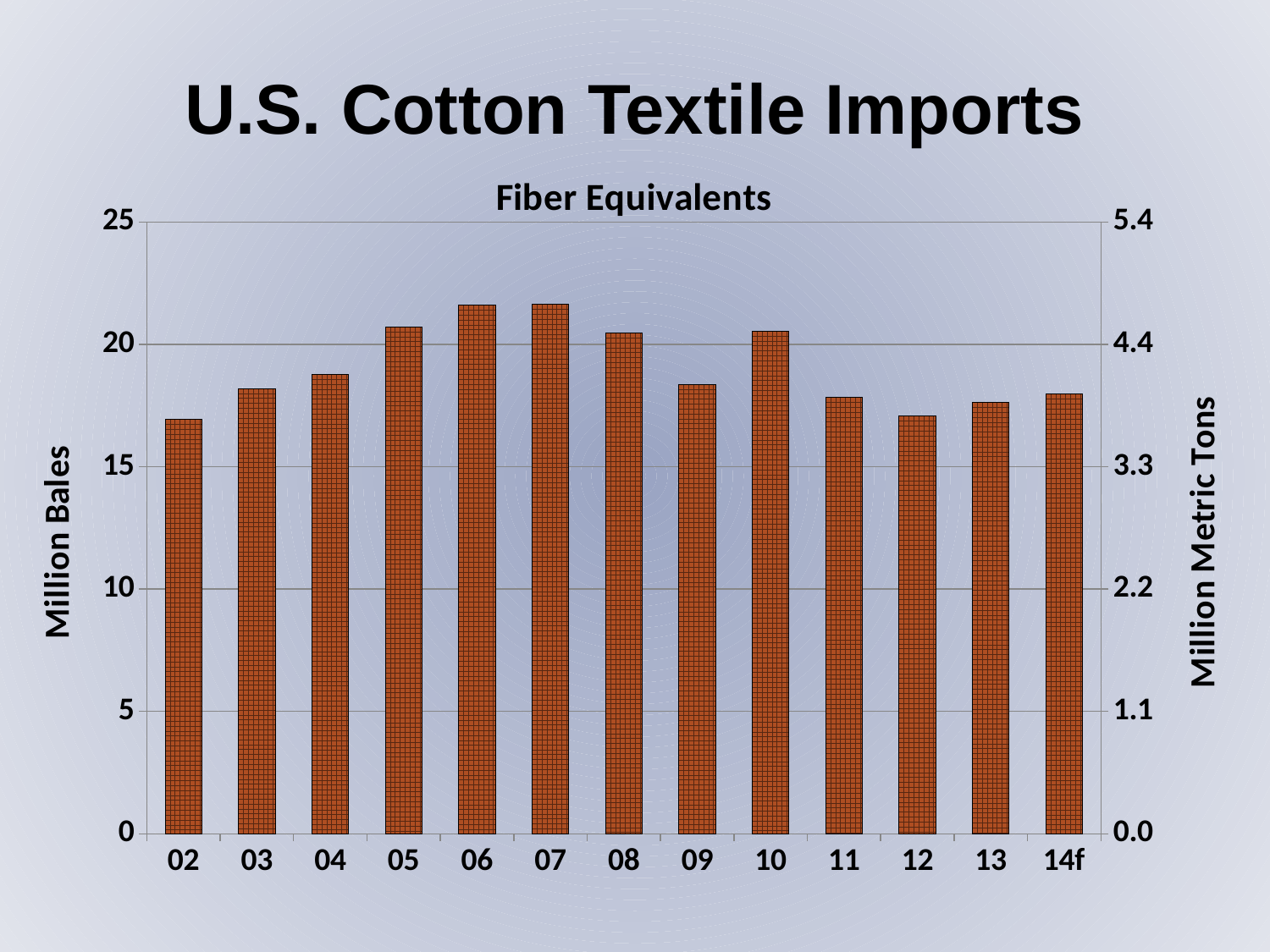
What is the label on the right vertical axis? Million Metric Tons What is the label on the left vertical axis? Million Bales Is the value for 09 greater or less than 15 million bales? greater Is the value for 06 greater or less than 20 million bales? greater Which has the larger value, 10 or 11? 10 What kind of chart is shown on the slide? bar chart Do the values rise or fall from 02 to 06? rise Is the value for 02 greater or less than 20 million bales? less How many years (categories) are plotted on the x axis? 13 Which has the larger value, 05 or 04? 05